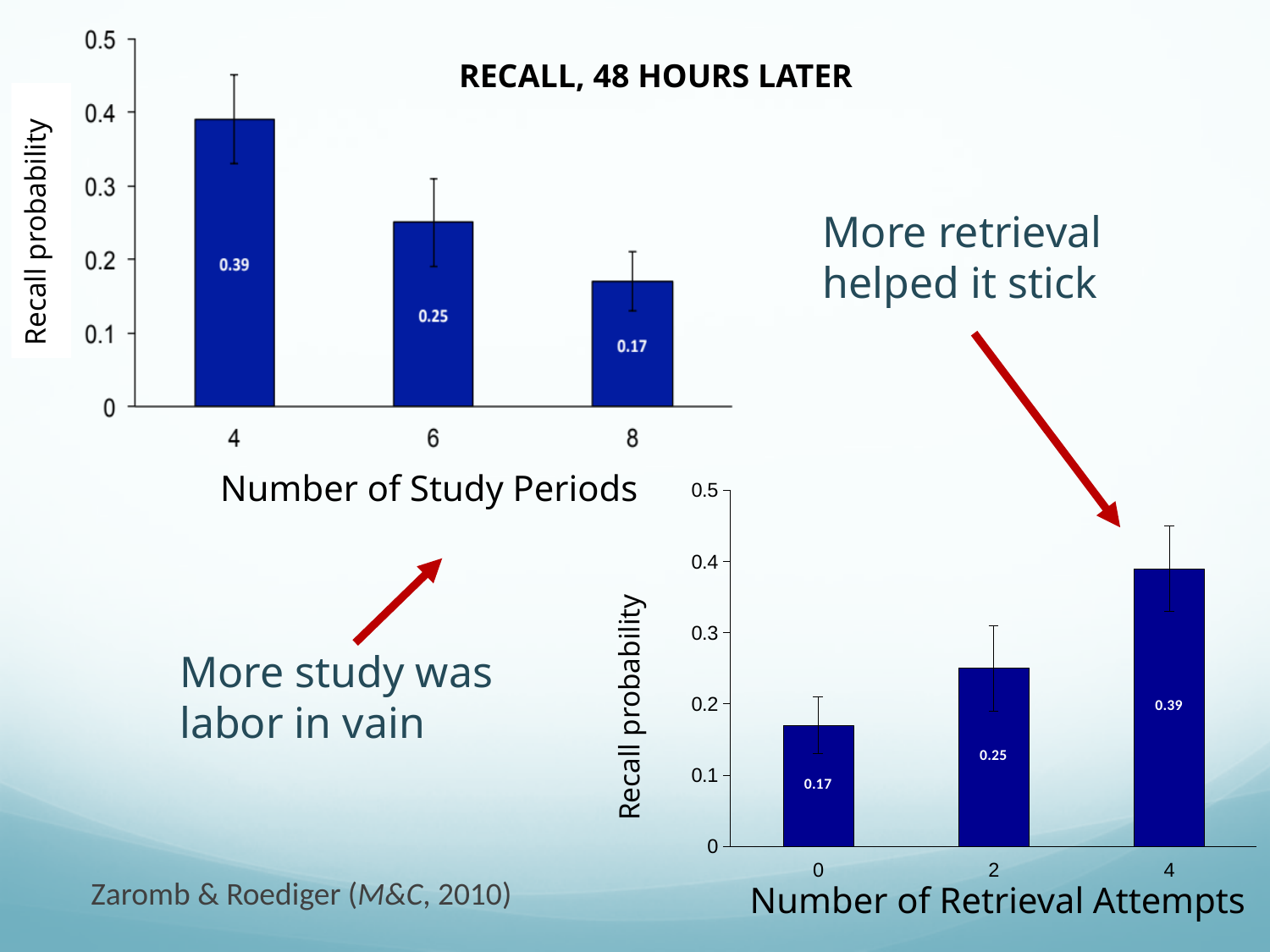
In the top-left chart (Number of Study Periods), which number of study periods has the lowest recall probability? 8 In the top-left chart (Number of Study Periods), what is the recall probability for 8 study periods? 0.17 In the bottom-right chart (Number of Retrieval Attempts), which number of retrieval attempts has the highest recall probability? 4 In the bottom-right chart (Number of Retrieval Attempts), what is the recall probability for 2 retrieval attempts? 0.25 What kind of chart is the bottom-right chart (Number of Retrieval Attempts)? bar chart In the bottom-right chart (Number of Retrieval Attempts), does recall probability rise or fall as the number of retrieval attempts increases? rise In the bottom-right chart (Number of Retrieval Attempts), which has a higher recall probability: 0 attempts or 2 attempts? 2 attempts In the bottom-right chart (Number of Retrieval Attempts), what is the recall probability for 4 retrieval attempts? 0.39 In the top-left chart (Number of Study Periods), what is the difference in recall probability between 4 and 8 study periods? 0.22 In the top-left chart (Number of Study Periods), what is the recall probability for 4 study periods? 0.39 In the bottom-right chart (Number of Retrieval Attempts), what is the difference in recall probability between 4 and 0 retrieval attempts? 0.22 In the top-left chart (Number of Study Periods), does recall probability rise or fall as the number of study periods increases? fall